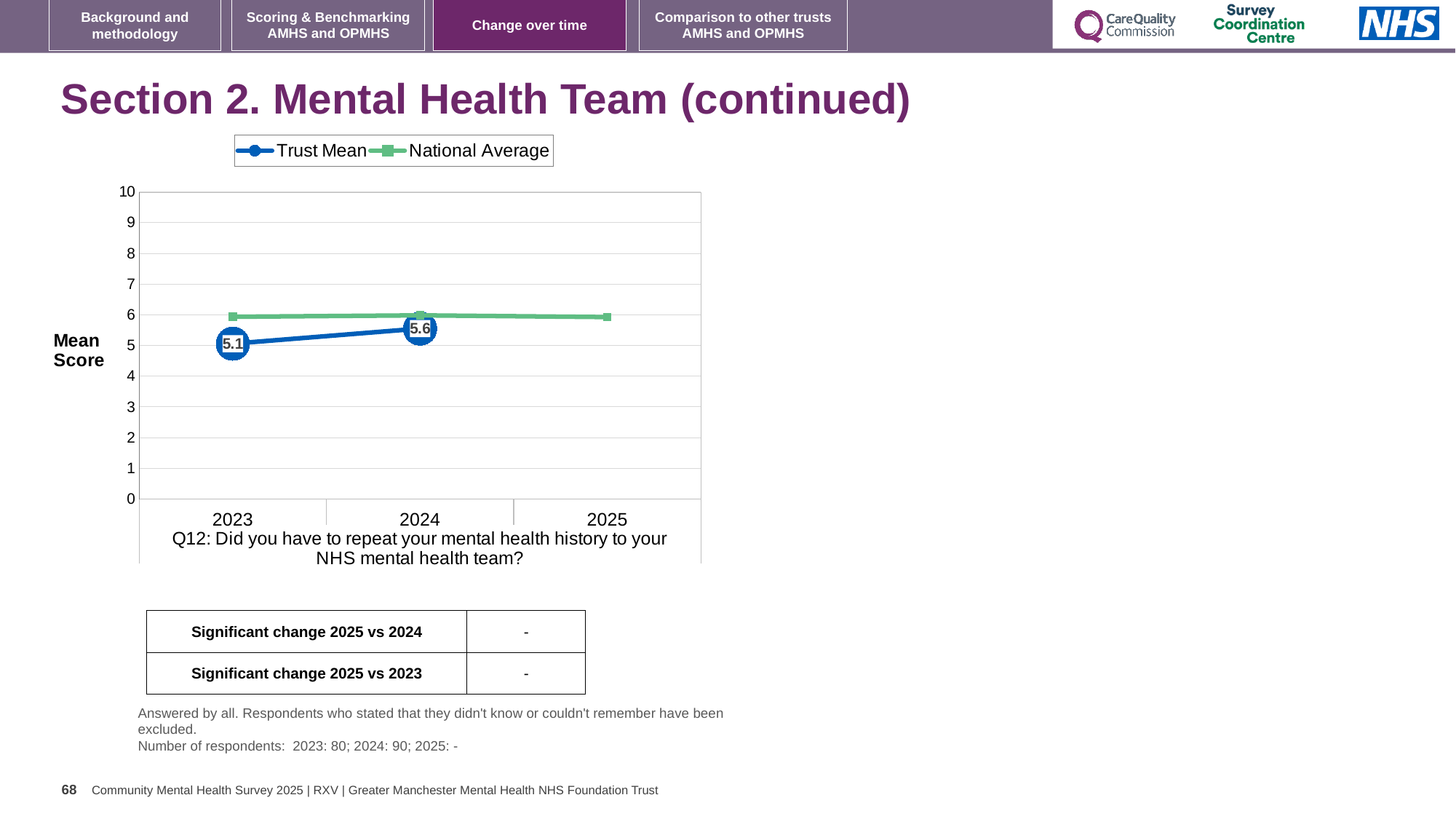
What kind of chart is shown on the slide? Line chart Which is larger, the Trust Mean in 2023 or in 2024? 2024 What is the Trust Mean score for 2023? 5.1 Is the National Average value for 2023 greater or less than 7? less In 2023, which series has the higher value, Trust Mean or National Average? National Average In which year is the Trust Mean lowest? 2023 In which year is the Trust Mean highest? 2024 What is the Trust Mean score for 2024? 5.6 How many series does the legend list? 2 Is the National Average value for 2025 greater or less than 5? greater What is the difference between the Trust Mean in 2024 and in 2023? 0.5 How many years are shown on the x axis? 3